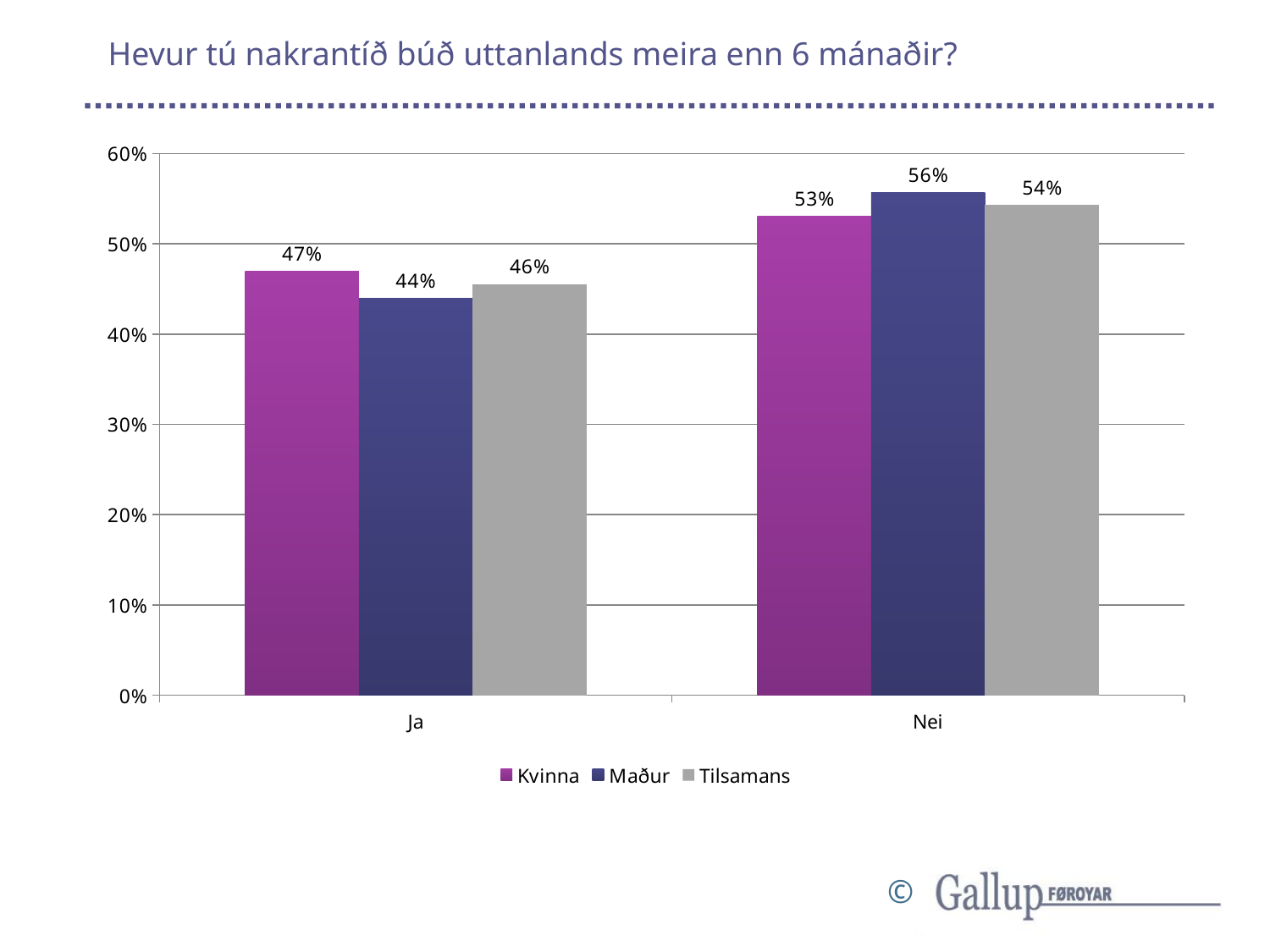
Which series has the lowest value in the Ja category? Maður What is the value for Tilsamans in the Ja category? 46% What is the value for Kvinna in the Nei category? 53% Is the value for Tilsamans in the Nei category greater or less than 50%? greater What is the value for Kvinna in the Ja category? 47% Which series has the highest value in the Nei category? Maður What is the value for Maður in the Nei category? 56% How many series does the legend list? 3 How many categories are shown on the x axis? 2 What is the difference between the Maður values for Nei and Ja? 12% Which is larger: the Kvinna value for Ja or the Kvinna value for Nei? Nei What kind of chart is shown on the slide? Bar chart